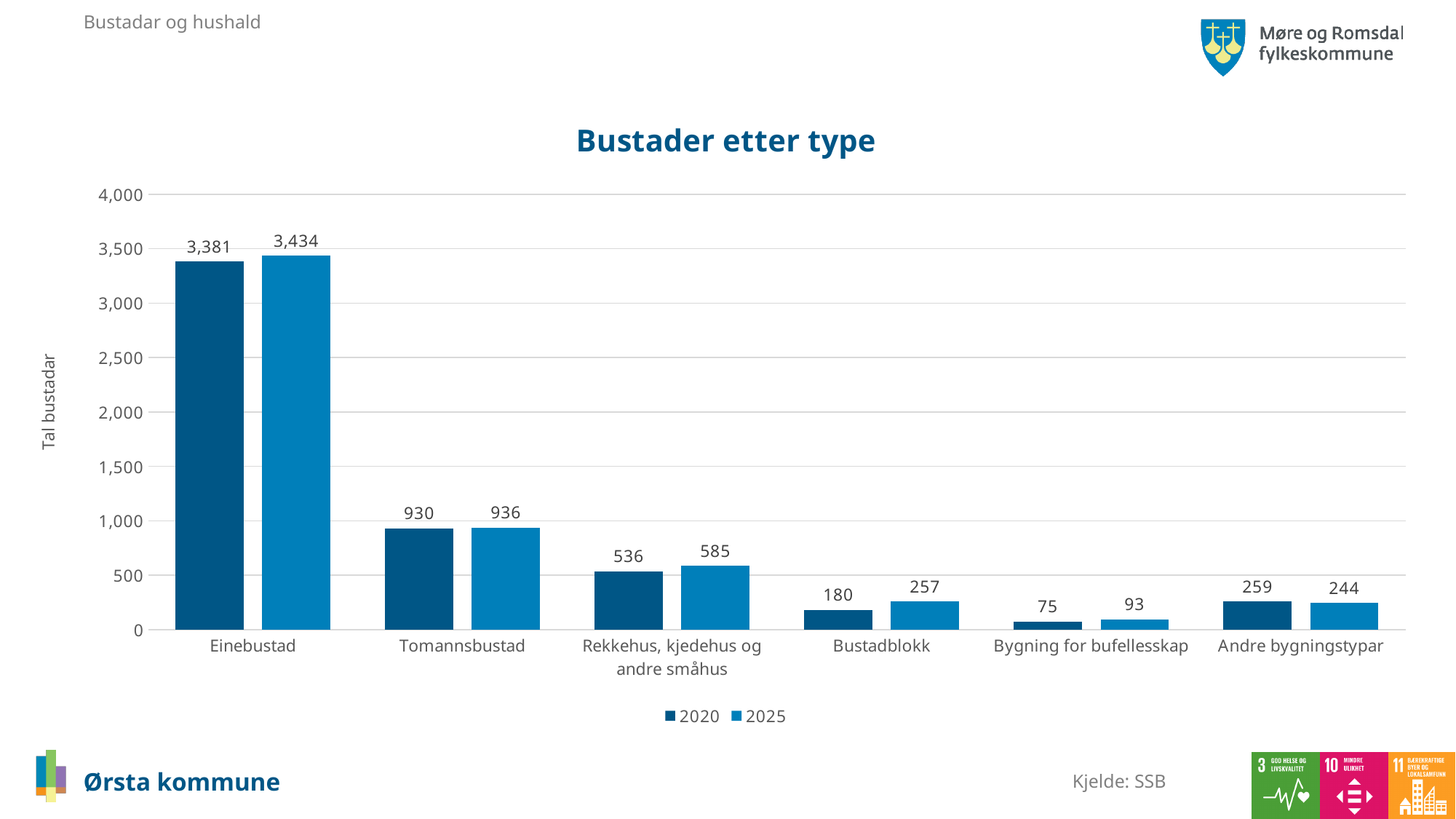
Which category has the highest value in 2020? Einebustad Is the 2025 value for Rekkehus, kjedehus og andre småhus greater or less than 500? greater What type of chart is shown? Bar chart What is the value for Bustadblokk in 2020? 180 What is the value for Einebustad in 2025? 3,434 What is the difference between the 2020 and 2025 values for Einebustad? 53 Which category has the lowest value in 2025? Bygning for bufellesskap How many series does the legend list? 2 What is the difference between the 2025 and 2020 values for Bustadblokk? 77 How many categories are shown on the x axis? 6 Which is larger for Andre bygningstypar: the 2020 value or the 2025 value? 2020 What is the value for Bygning for bufellesskap in 2025? 93